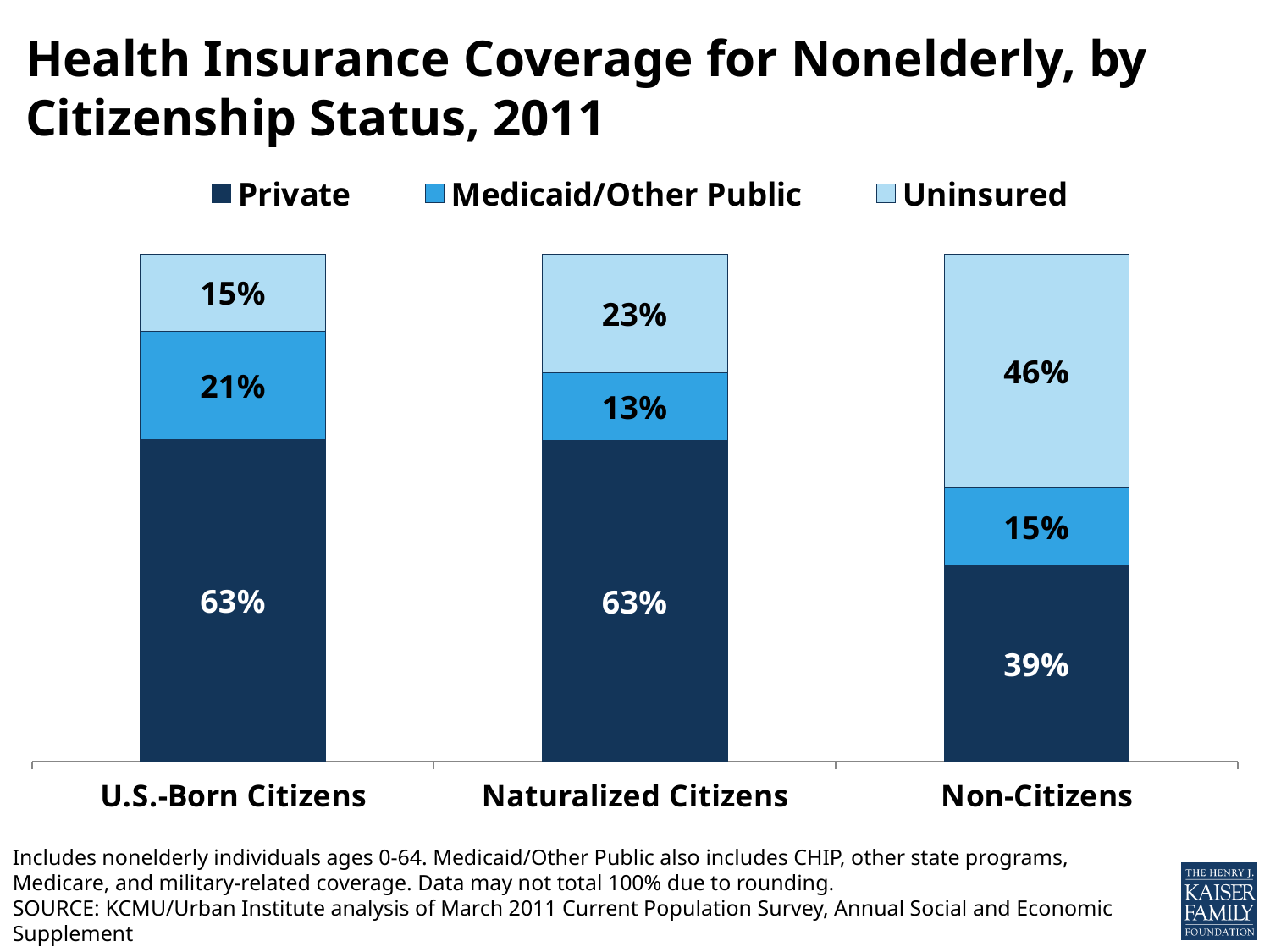
What is the total of the stacked bar for Naturalized Citizens? 99% How many citizenship groups are shown on the x axis? 3 What is the Uninsured value for Non-Citizens? 46% What is the Medicaid/Other Public value for Naturalized Citizens? 13% Which citizenship group has the lowest Private coverage share? Non-Citizens Which series is shown in the darkest blue colour? Private Which is larger: the Medicaid/Other Public value for U.S.-Born Citizens or for Naturalized Citizens? U.S.-Born Citizens What is the difference between the Uninsured value for Non-Citizens and the Uninsured value for U.S.-Born Citizens? 31% How many series does the legend list? 3 Which citizenship group has the highest Uninsured share? Non-Citizens What kind of chart is shown on the slide? Stacked bar chart What is the Private coverage value for U.S.-Born Citizens? 63%